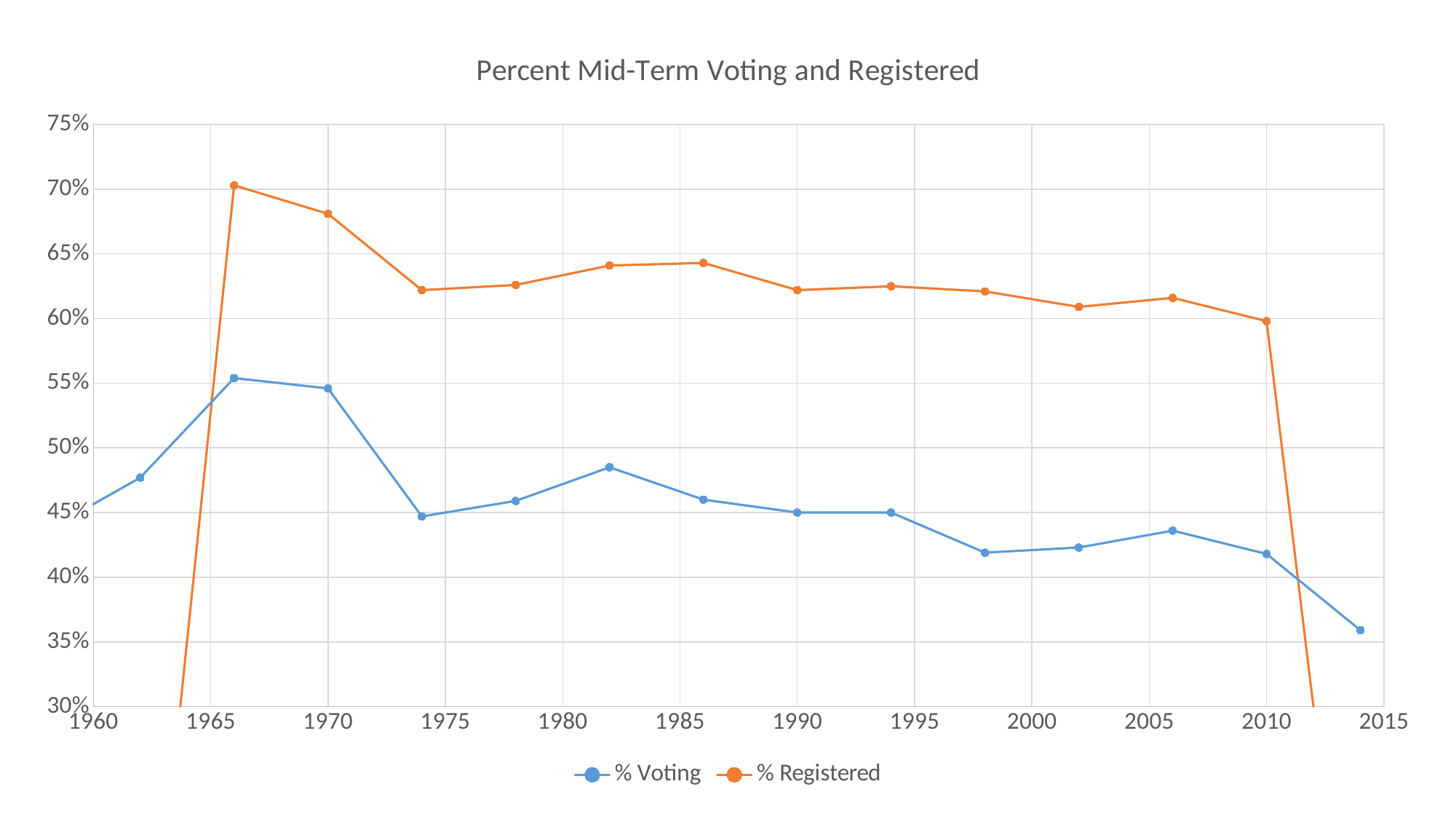
Which year has the larger % Registered value, 1970 or 1974? 1970 Is the % Voting value for 1970 greater or less than 50%? greater Which year has the larger % Voting value, 1982 or 1986? 1982 Is the % Voting value for 2014 greater or less than 40%? less What kind of chart is shown on the slide? line chart In which year does the % Registered series reach its highest value? 1966 How many series does the legend list? 2 In which year does the % Voting series reach its lowest value? 2014 Is the % Registered value for 2002 greater or less than 65%? less Does the % Voting series rise or fall between 1994 and 1998? fall In which year does the % Voting series reach its highest value? 1966